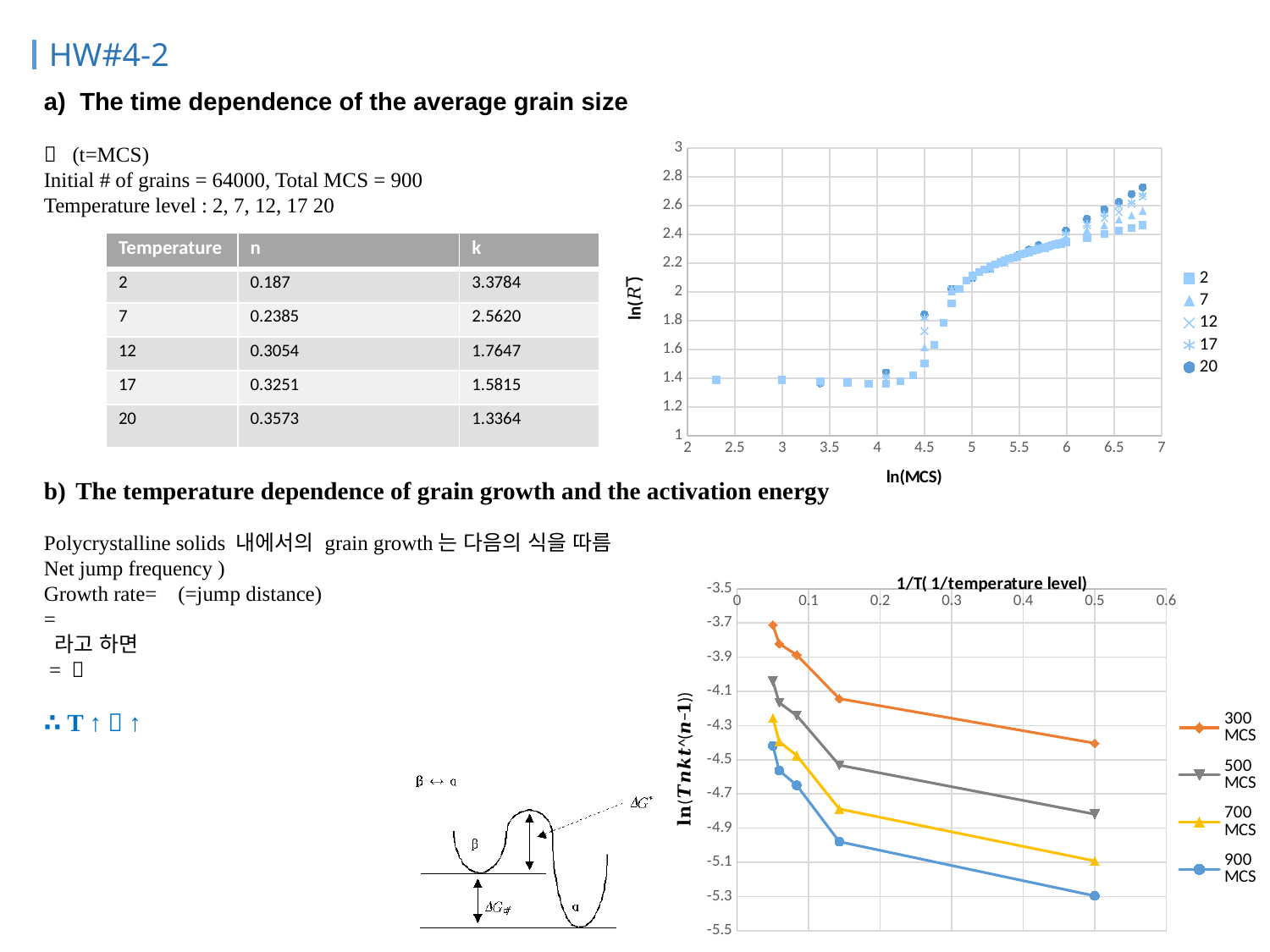
What kind of chart is the top-right chart plotting ln(R) against ln(MCS)? scatter chart On the top-right chart, is the value of series 2 at the far right (ln(MCS) near 6.8) greater or less than 2.6? less On the top-right chart, is the value of series 20 at the far right (ln(MCS) near 6.8) greater or less than 2.6? greater On the bottom-right chart, which series has the highest values across the x axis? 300 MCS What is the x-axis title of the top-right chart? ln(MCS) On the top-right chart (ln(R) vs ln(MCS)), how many series does the legend list? 5 What kind of chart is the bottom-right chart plotting ln(Tnkt^(n-1)) against 1/T? line chart On the top-right chart, what are the legend entries? 2, 7, 12, 17, 20 On the bottom-right chart, do the values fall or rise as 1/T increases? fall On the bottom-right chart (ln(Tnkt^(n-1)) vs 1/T), how many series does the legend list? 4 On the bottom-right chart, which series has the lowest values across the x axis? 900 MCS On the top-right chart, do the ln(R) values rise or fall as ln(MCS) increases? rise